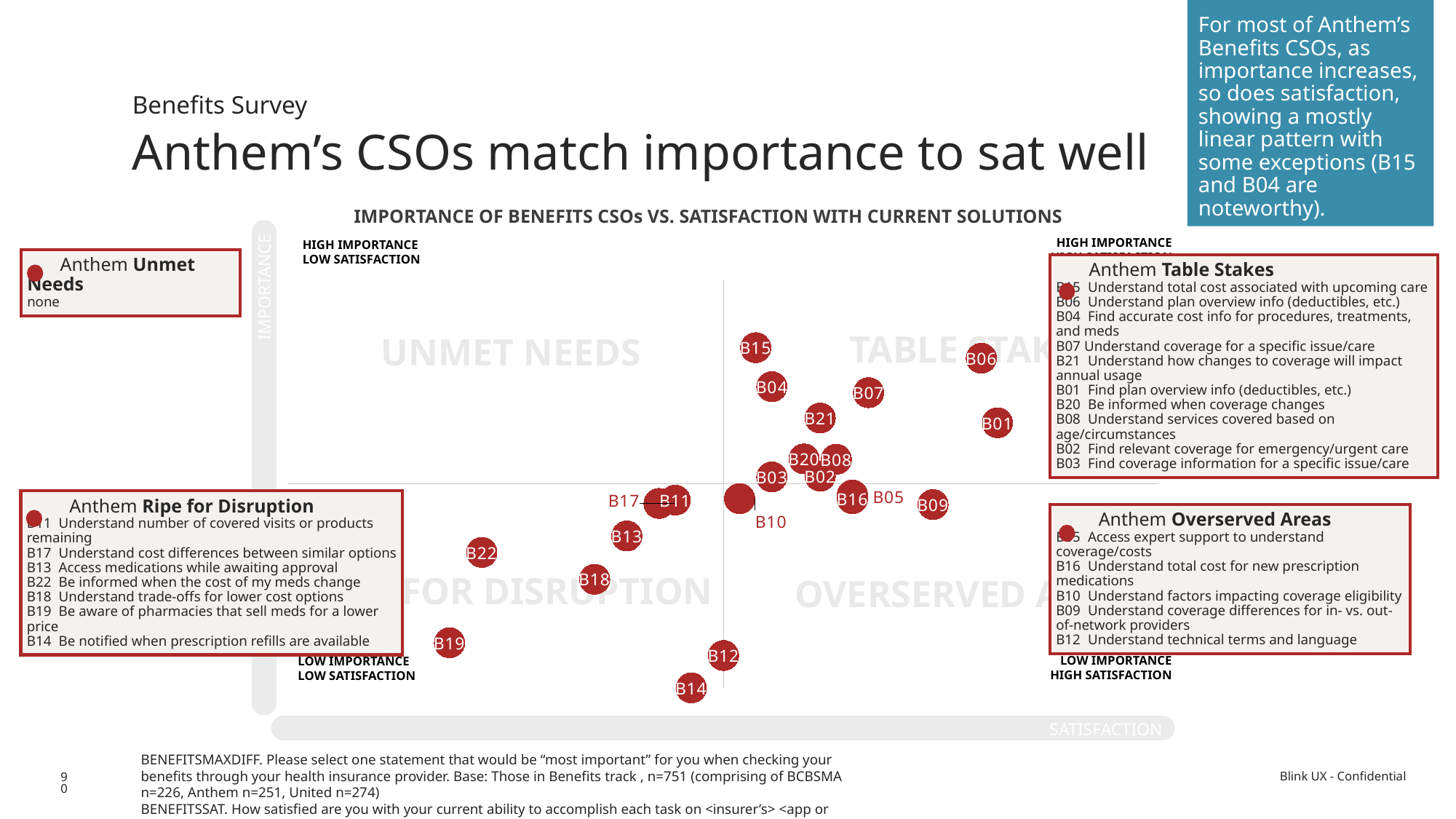
Which point has higher satisfaction, B22 or B18? B18 Which point has higher importance, B15 or B04? B15 Which point has the lowest importance on the chart? B14 Which point has higher importance, B19 or B14? B19 In which quadrant of the chart does B06 fall? Table Stakes In which quadrant of the chart does B22 fall? Ripe for Disruption How many labeled points are plotted on the chart? 22 As satisfaction increases along the x axis, does importance generally rise or fall? rise What is the title of the chart? IMPORTANCE OF BENEFITS CSOs VS. SATISFACTION WITH CURRENT SOLUTIONS What kind of chart is shown on the slide? scatter chart Which point has the lowest satisfaction on the chart? B19 Which quadrant of the chart contains no points? Unmet Needs